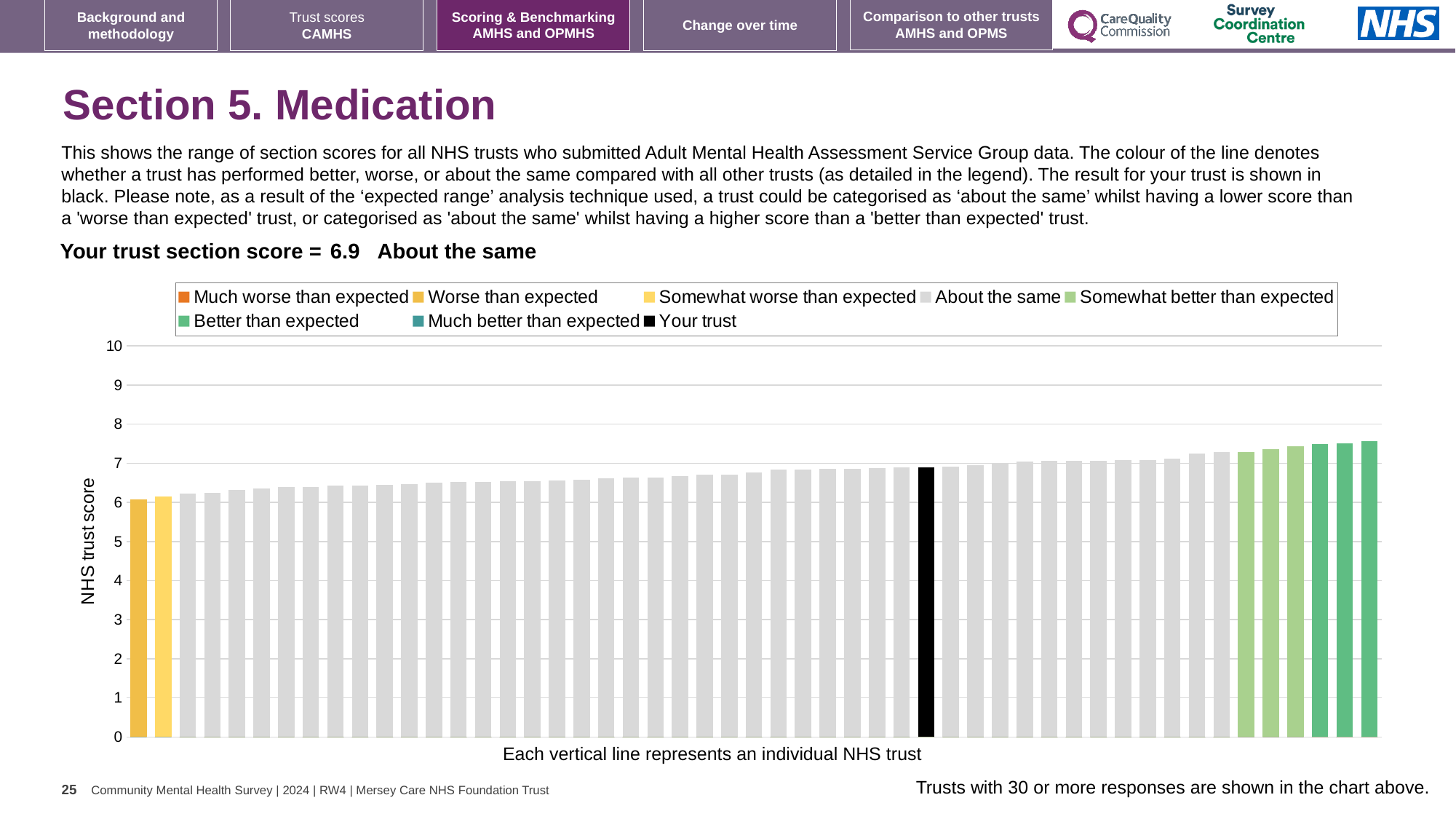
How many entries does the chart legend list? 8 What is the label on the vertical axis of the chart? NHS trust score Is the value for the black 'Your trust' bar greater or less than 6? greater What colour is the bar representing your trust? black Do the bar values rise or fall from left to right along the x axis? rise What is the section score for your trust shown on the slide? 6.9 Is the value for the leftmost bar greater or less than 7? less What kind of chart is shown on the slide? bar chart Which category is your trust placed in for this section? About the same Is the value for the rightmost bar greater or less than 7? greater How many bars in the chart are coloured black? 1 Which is larger, the value of the leftmost bar or the value of the rightmost bar? the rightmost bar